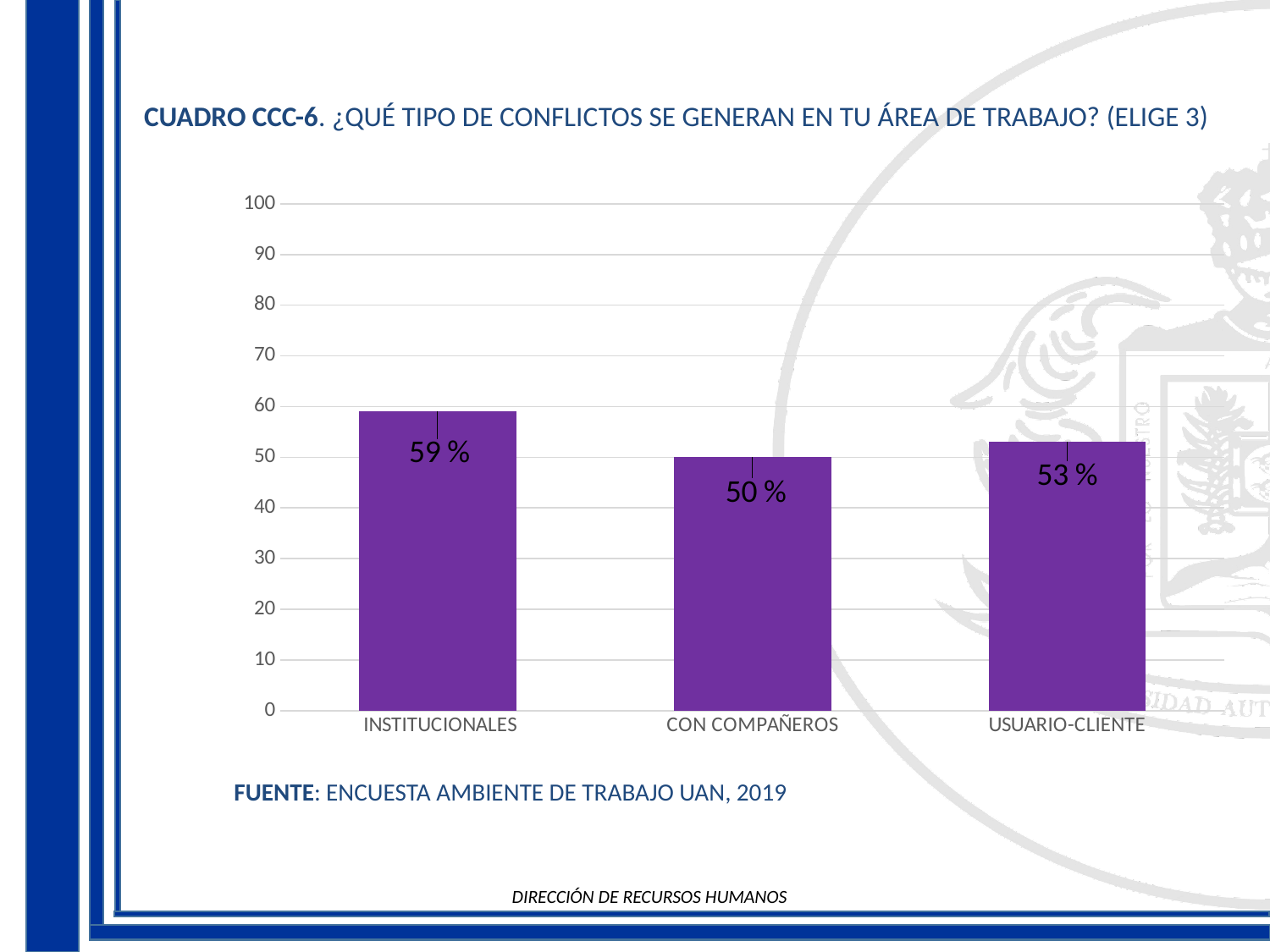
What kind of chart is shown on the slide? bar chart What source is cited below the chart? ENCUESTA AMBIENTE DE TRABAJO UAN, 2019 What is the difference between the values for INSTITUCIONALES and USUARIO-CLIENTE? 6 % What is the value for USUARIO-CLIENTE? 53 % Which category has the lowest value? CON COMPAÑEROS Which category has the highest value? INSTITUCIONALES What is the value for CON COMPAÑEROS? 50 % Is the value for INSTITUCIONALES greater or less than 50? greater What is the difference between the values for INSTITUCIONALES and CON COMPAÑEROS? 9 % What is the value for INSTITUCIONALES? 59 % Which is larger, the value for USUARIO-CLIENTE or the value for CON COMPAÑEROS? USUARIO-CLIENTE How many categories are shown on the x axis? 3